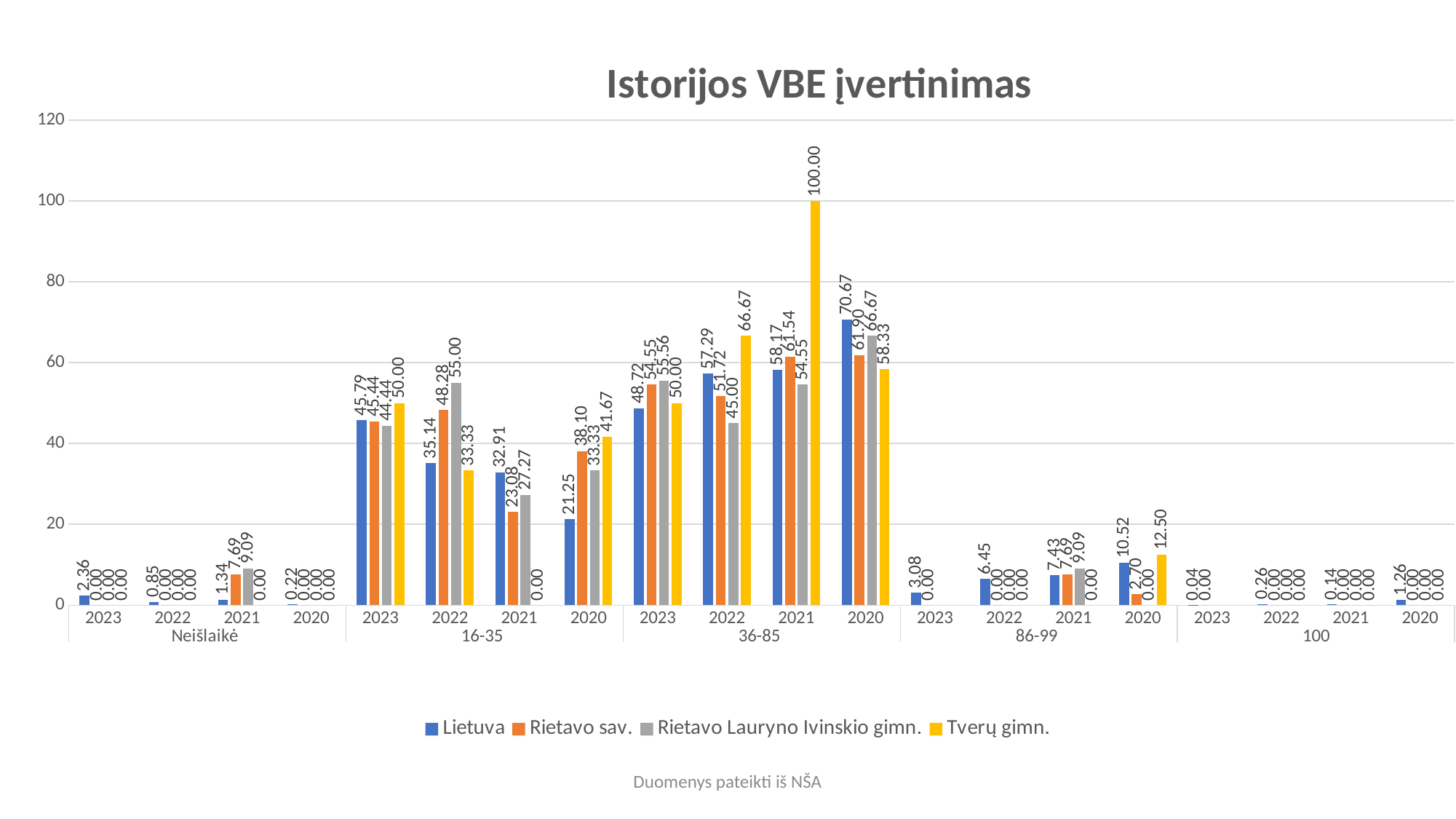
In the 16-35 group for 2022, which is larger: the value for Lietuva or the value for Rietavo sav.? Rietavo sav. What is the value for Rietavo sav. in the 86-99 group for 2020? 2.70 What type of chart is shown on the slide? bar chart What is the value for Lietuva in the 36-85 group for 2020? 70.67 Which series has the lowest value in the 16-35 group for 2020? Lietuva Which series has the highest value in the 36-85 group for 2021? Tverų gimn. What is the value for Rietavo Lauryno Ivinskio gimn. in the 16-35 group for 2022? 55.00 What is the value for Tverų gimn. in the 36-85 group for 2021? 100.00 How many year categories are shown within each score group on the x axis? 4 What is the title of the chart? Istorijos VBE įvertinimas How many series does the legend list? 4 What is the difference between the Lietuva and Rietavo sav. values in the 36-85 group for 2020? 8.77